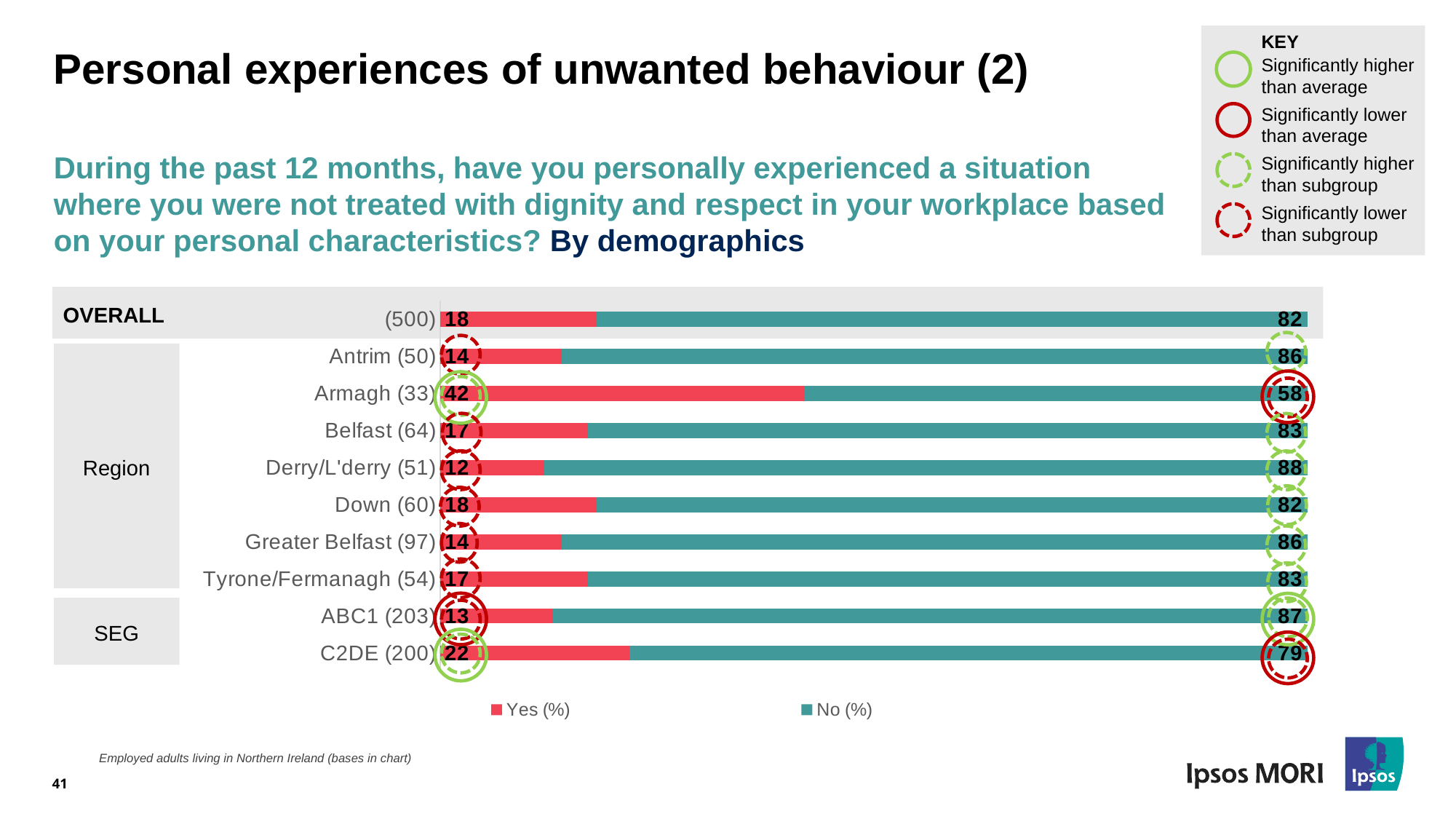
What is the Yes (%) value for the OVERALL (500) bar? 18 What kind of chart is shown on the slide? Stacked bar chart Which has a larger No (%) value, Antrim (50) or Belfast (64)? Antrim (50) What is the No (%) value for C2DE (200)? 79 What is the No (%) value for Derry/L'derry (51)? 88 What is the Yes (%) value for Armagh (33)? 42 What is the total of the stacked bar for Down (60)? 100 How many series does the legend list? 2 How many categories (bars) are shown in the chart? 10 What is the difference between the Yes (%) values for C2DE (200) and ABC1 (203)? 9 Which category has the lowest Yes (%) value? Derry/L'derry (51) Which category has the highest Yes (%) value? Armagh (33)